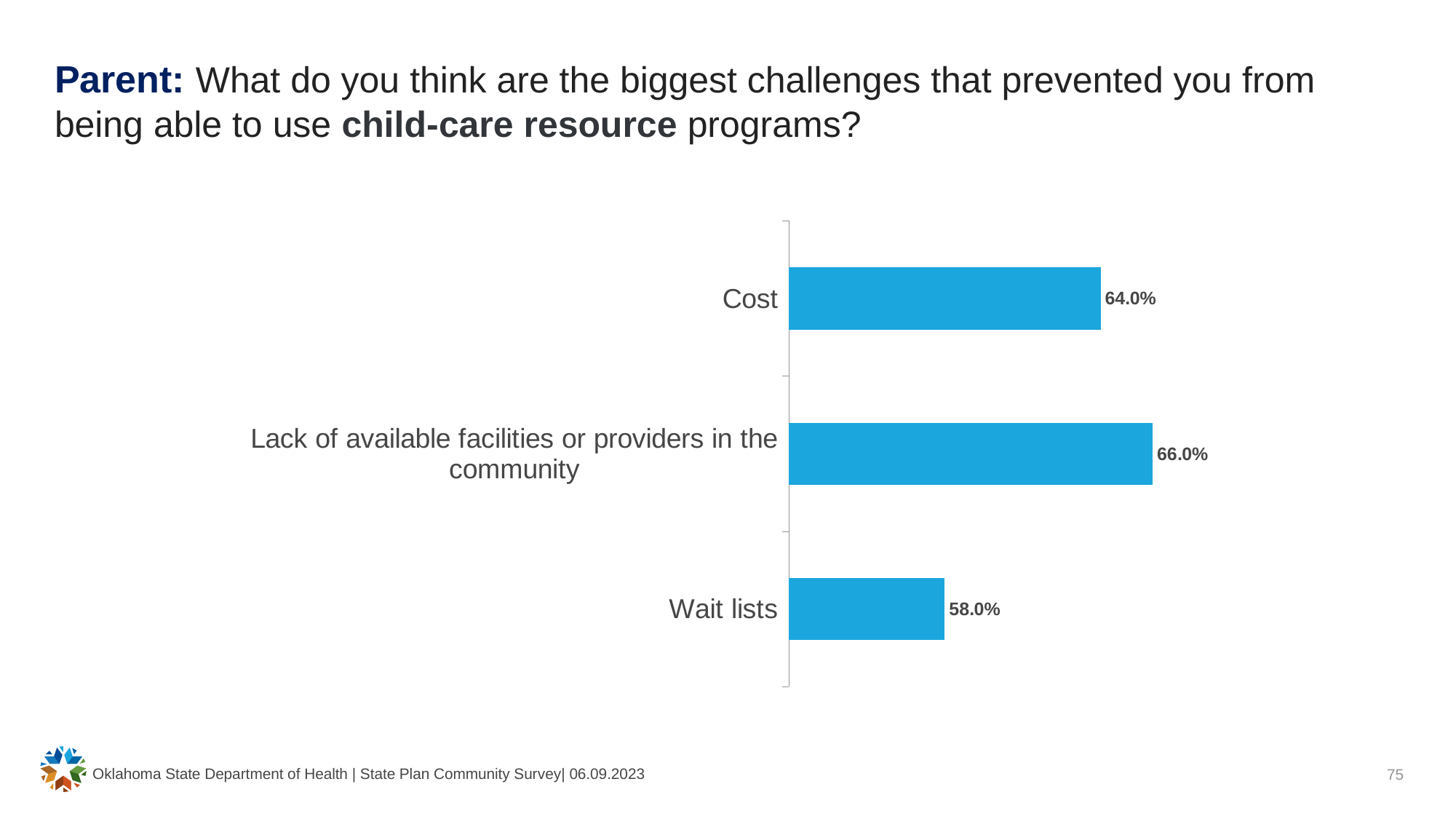
Which category is listed at the bottom of the chart? Wait lists Which is larger, the value for Cost or the value for Wait lists? Cost Which category has the lowest value? Wait lists What is the value for Wait lists? 58.0% Which category has the highest value? Lack of available facilities or providers in the community What is the difference between the values for Cost and Wait lists? 6.0% What is the value for Lack of available facilities or providers in the community? 66.0% What is the difference between the values for Lack of available facilities or providers in the community and Cost? 2.0% What is the value for Cost? 64.0% What colour are the bars in the chart? Blue How many categories are shown in the chart? 3 What kind of chart is shown on the slide? Bar chart